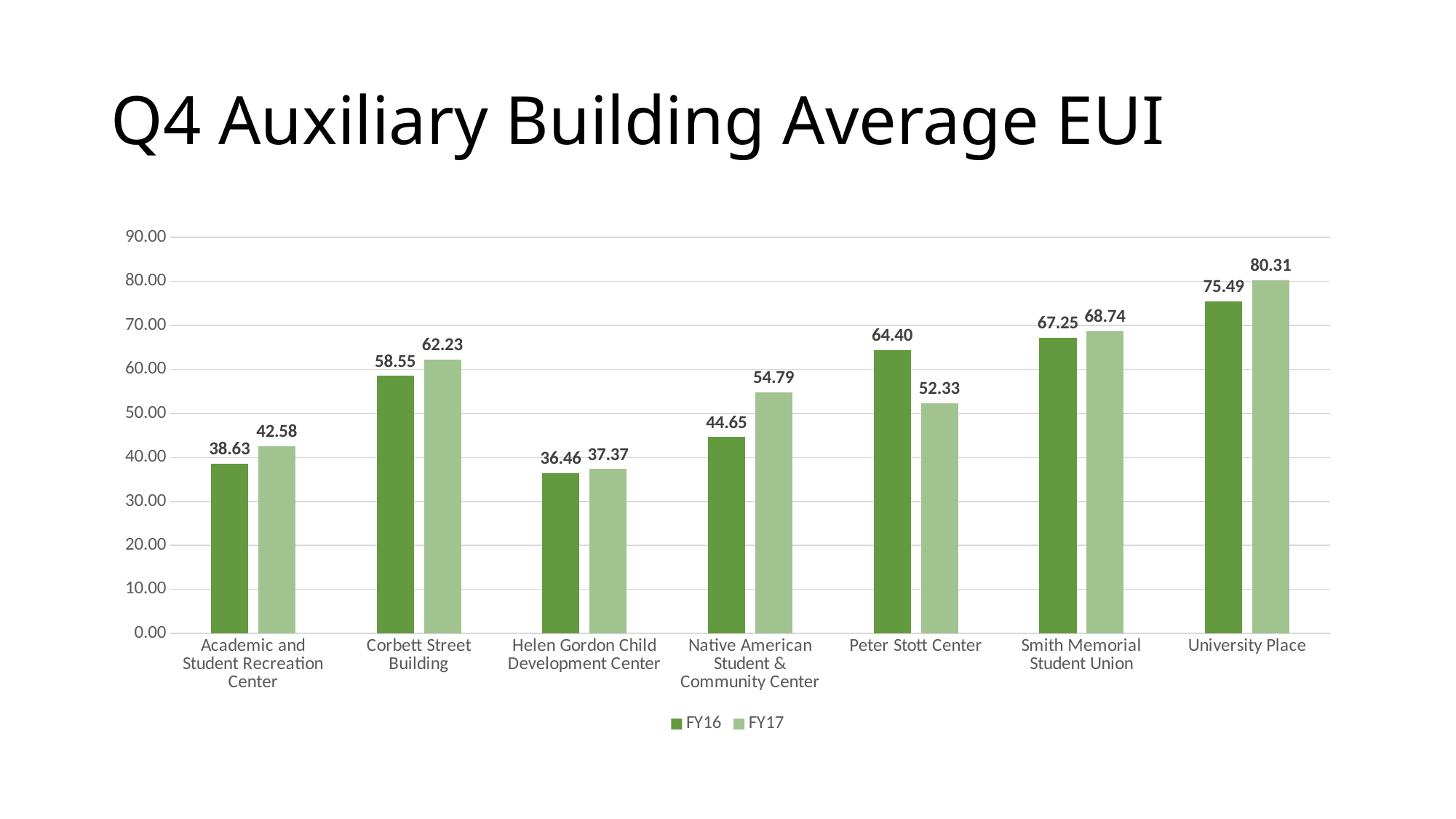
What kind of chart is shown on the slide? Bar chart What is the FY17 value for Native American Student & Community Center? 54.79 What is the title of the chart? Q4 Auxiliary Building Average EUI How many buildings are shown on the x axis? 7 What is the FY16 value for Peter Stott Center? 64.40 Is the FY17 value for Smith Memorial Student Union greater or less than 60.00? greater Which is larger for Peter Stott Center, the FY16 value or the FY17 value? FY16 Which building has the lowest FY16 value? Helen Gordon Child Development Center How many series does the legend list? 2 Which building has the highest FY17 value? University Place What is the FY16 value for Corbett Street Building? 58.55 What is the difference between the FY17 and FY16 values for Academic and Student Recreation Center? 3.95